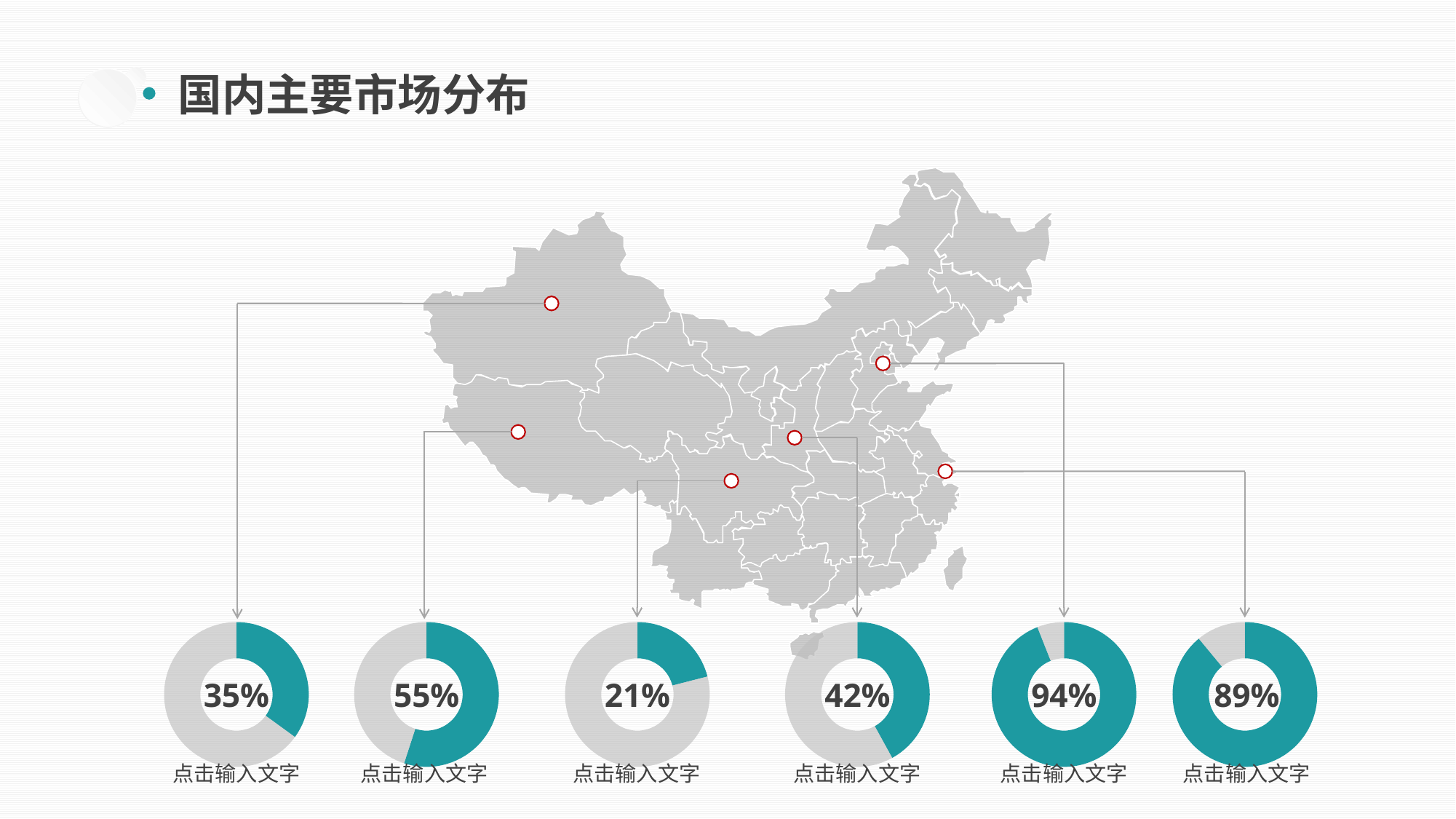
What value is shown in the first (leftmost) donut chart? 35% What is the difference between the values in the fifth and sixth donut charts? 5% Which is larger, the value in the second donut chart or the value in the fourth donut chart? The second (55%) What kind of charts are shown at the bottom of the slide? Donut (pie) charts Which of the six donut charts shows the highest percentage? The fifth donut chart (94%) How many donut charts are shown on the slide? 6 What value is shown in the sixth (rightmost) donut chart? 89% What value is shown in the second donut chart from the left? 55% What value is shown in the fifth donut chart from the left? 94% What value is shown in the fourth donut chart from the left? 42% What value is shown in the third donut chart from the left? 21% Which of the six donut charts shows the lowest percentage? The third donut chart (21%)